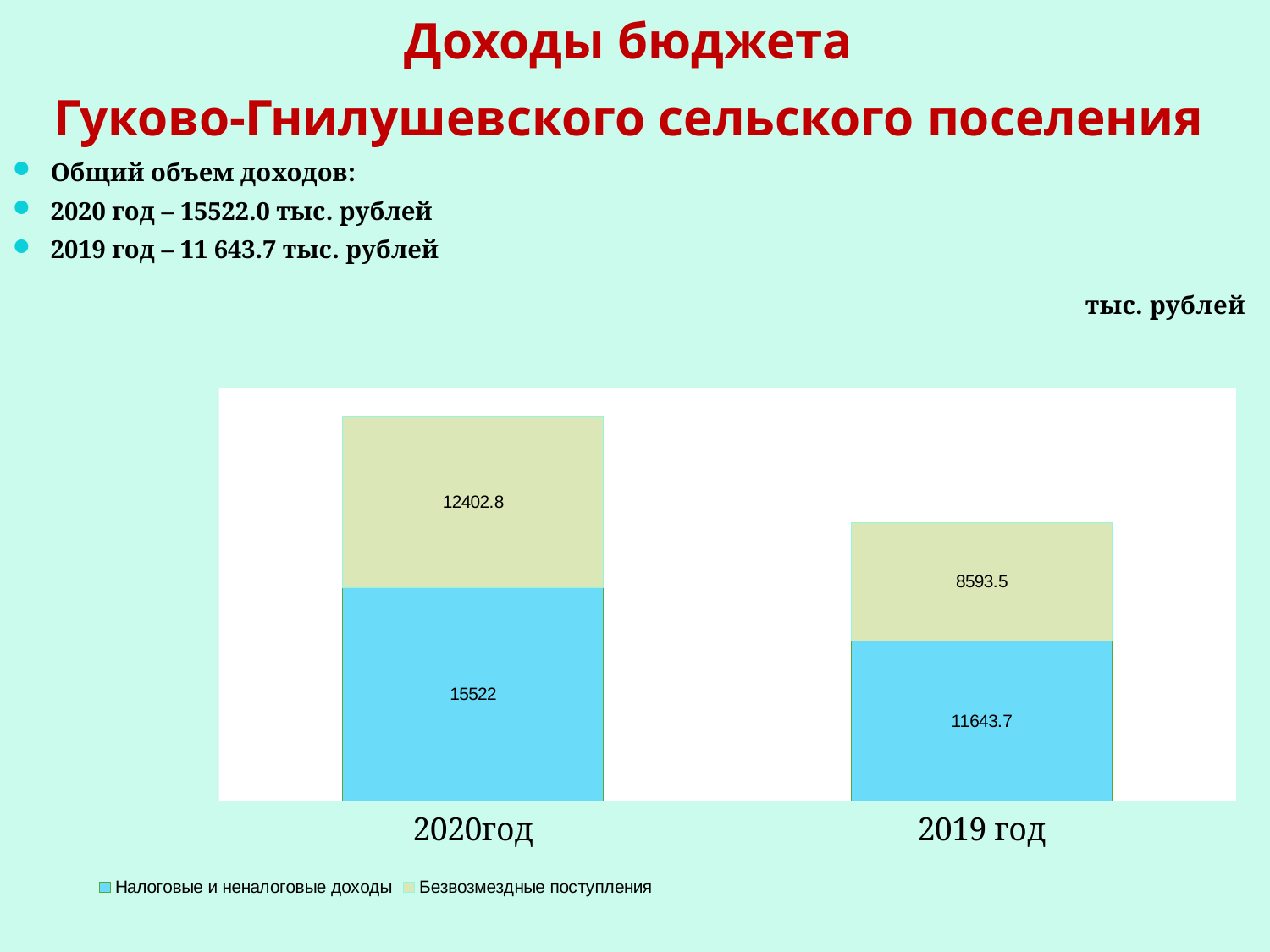
How many categories (years) are shown on the x axis of the chart? 2 Which year has the higher value for Налоговые и неналоговые доходы? 2020год Which year has the lower value for Безвозмездные поступления? 2019 год What is the value of Безвозмездные поступления for 2020год? 12402.8 What is the value of Налоговые и неналоговые доходы for 2019 год? 11643.7 What is the difference between the Налоговые и неналоговые доходы values for 2020год and 2019 год? 3878.3 How many series does the chart legend list? 2 What is the value of Безвозмездные поступления for 2019 год? 8593.5 What is the total of the stacked bar for 2019 год? 20237.2 What is the value of Налоговые и неналоговые доходы for 2020год? 15522 Which series is shown in blue in the chart? Налоговые и неналоговые доходы What type of chart is shown on the slide? Stacked bar chart